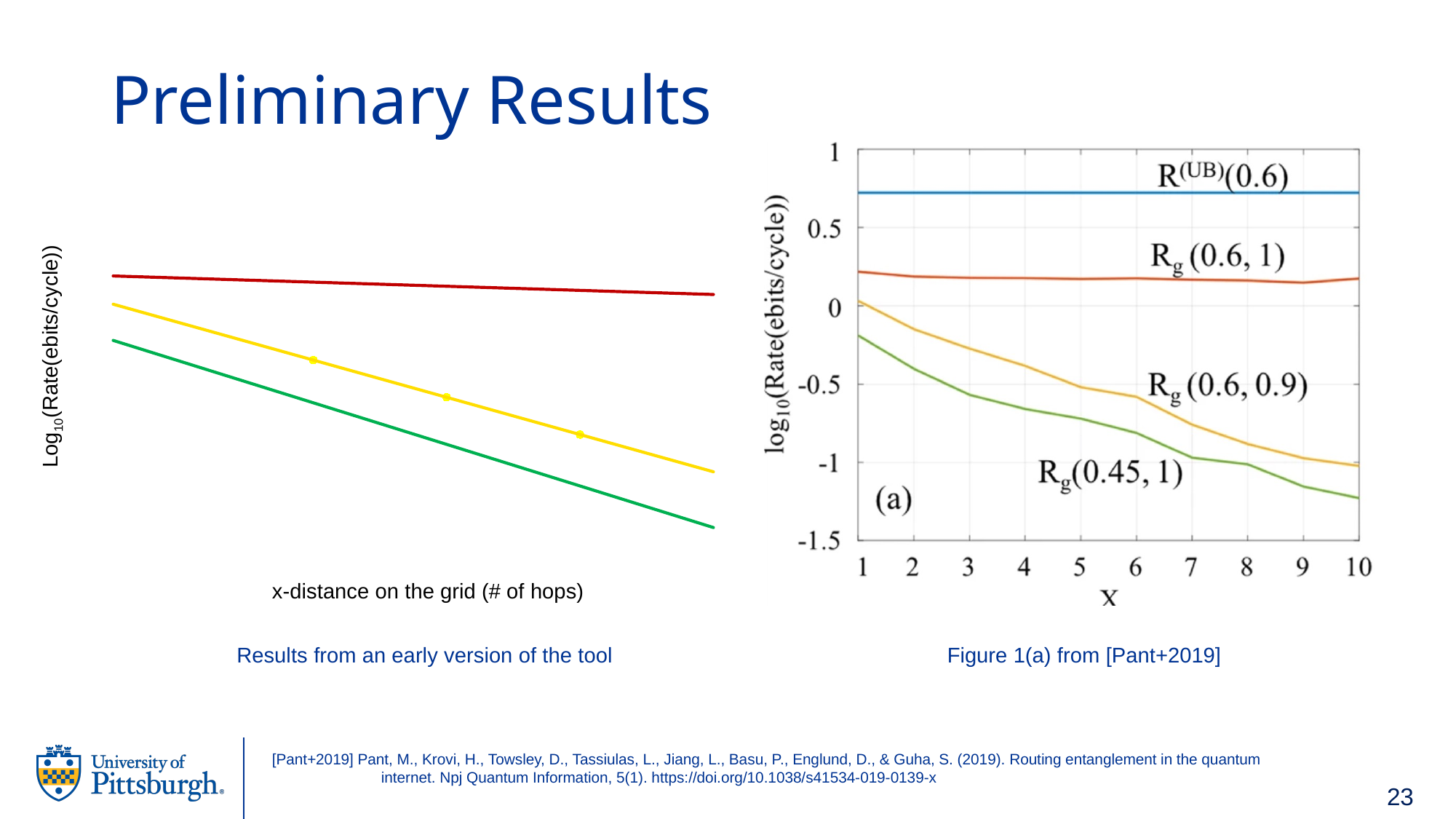
On the left chart (Results from an early version of the tool), what kind of chart is it? line chart On the right chart (Figure 1(a) from [Pant+2019]), which curve is the lowest at x = 10? Rg(0.45, 1) On the left chart (Results from an early version of the tool), do the lines rise or fall as x-distance increases? fall On the right chart (Figure 1(a) from [Pant+2019]), is the value of R^(UB)(0.6) greater or less than 0.5? greater On the left chart (Results from an early version of the tool), which coloured line is the highest? red On the left chart (Results from an early version of the tool), which coloured line is the lowest? green On the left chart (Results from an early version of the tool), what is the x-axis label? x-distance on the grid (# of hops) On the right chart (Figure 1(a) from [Pant+2019]), how many labelled curves are shown? 4 On the right chart (Figure 1(a) from [Pant+2019]), which curve is the highest? R^(UB)(0.6) On the left chart (Results from an early version of the tool), how many lines are plotted? 3 On the right chart (Figure 1(a) from [Pant+2019]), is the value of Rg(0.45, 1) at x = 10 greater or less than -1? less On the right chart (Figure 1(a) from [Pant+2019]), does the Rg(0.6, 0.9) curve rise or fall as x increases from 1 to 10? fall